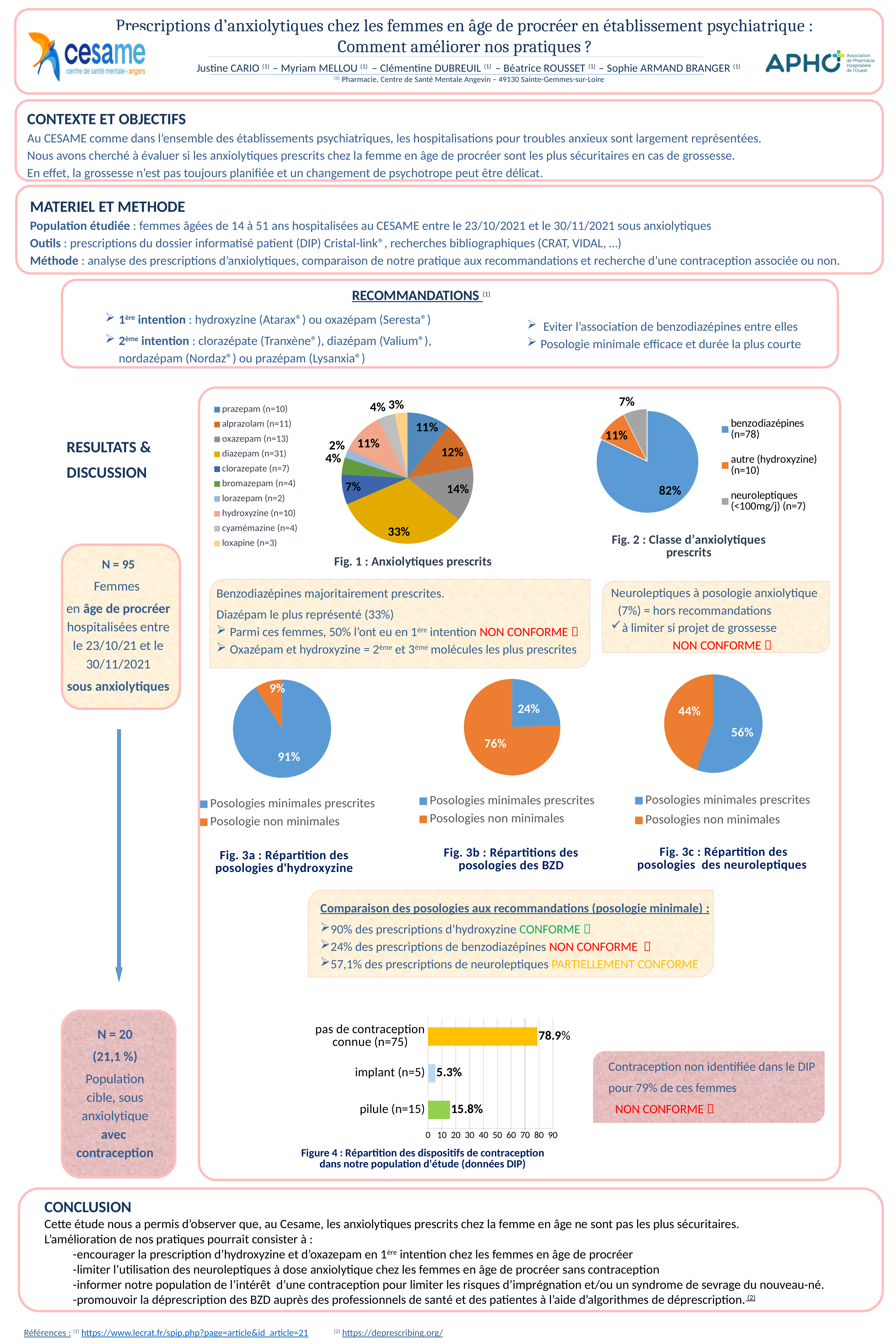
In Fig. 1 (Anxiolytiques prescrits), how many anxiolytics are listed in the legend? 10 In Fig. 3b (Répartitions des posologies des BZD), which is larger: 'Posologies minimales prescrites' or 'Posologies non minimales'? Posologies non minimales In Fig. 1 (Anxiolytiques prescrits), which anxiolytic has the smallest share? lorazepam (n=2) In Figure 4 (Répartition des dispositifs de contraception), which category has the lowest value? implant (n=5) In Figure 4 (Répartition des dispositifs de contraception), what is the value for 'pilule (n=15)'? 15.8% In Fig. 2 (Classe d'anxiolytiques prescrits), what is the difference in percentage points between benzodiazépines and neuroleptiques? 75 In Fig. 2 (Classe d'anxiolytiques prescrits), what share of the pie is benzodiazépines? 82% In Fig. 3a (Répartition des posologies d'hydroxyzine), what percentage is 'Posologies minimales prescrites'? 91% In Fig. 3c (Répartition des posologies des neuroleptiques), what percentage is 'Posologies non minimales'? 44% In Fig. 1 (Anxiolytiques prescrits), which anxiolytic has the largest share? diazepam (n=31) In Fig. 1 (Anxiolytiques prescrits), what percentage of the pie is diazepam? 33% What kind of chart is Figure 4 (Répartition des dispositifs de contraception)? bar chart